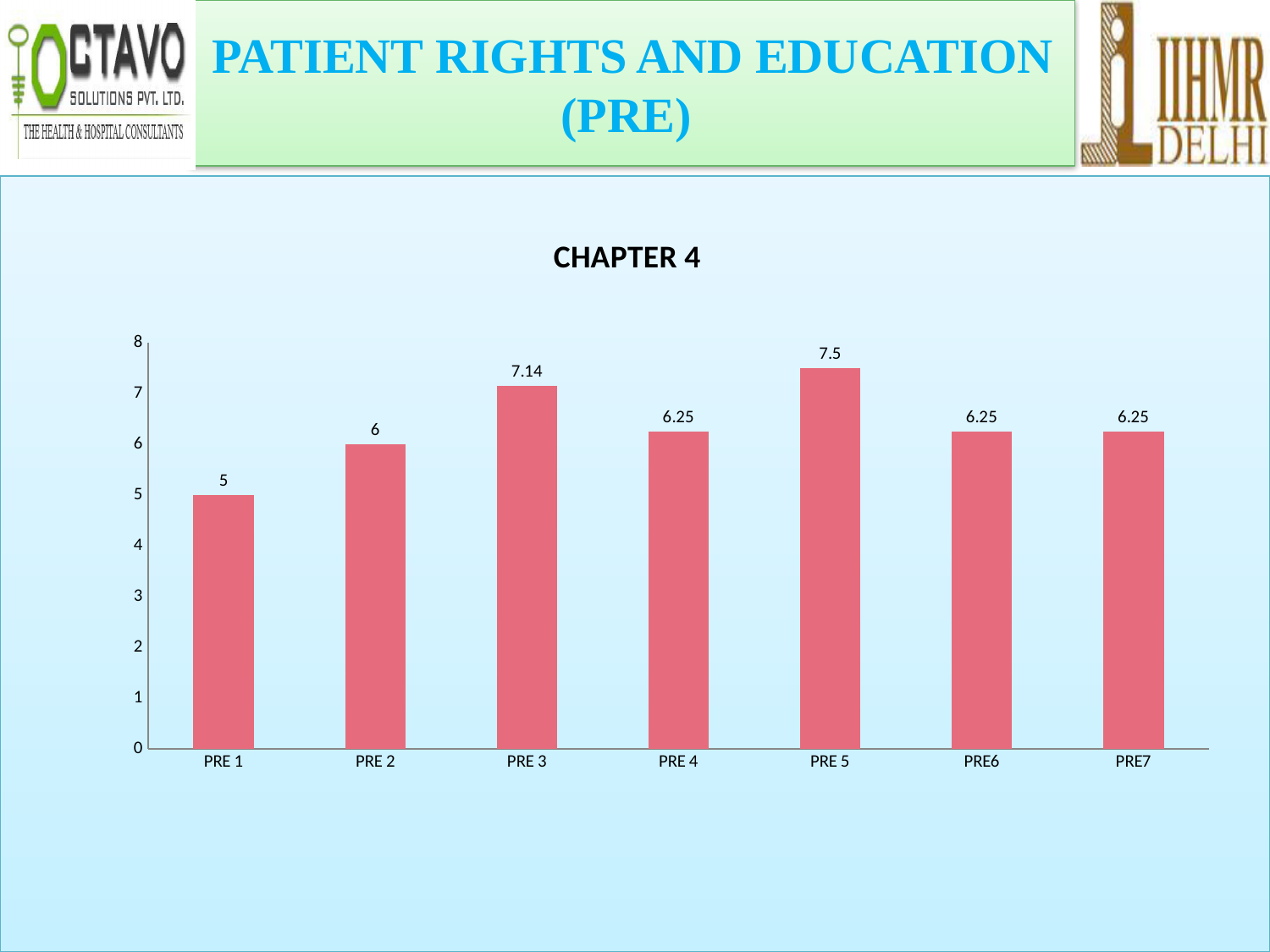
What is the difference between the values for PRE 3 and PRE 2? 1.14 Which category has the highest value? PRE 5 What is the value for PRE 1? 5 Which is larger, the value for PRE 3 or the value for PRE 4? PRE 3 Which category has the lowest value? PRE 1 What is the value for PRE6? 6.25 What is the title of the chart? CHAPTER 4 What is the difference between the values for PRE 5 and PRE 1? 2.5 How many categories are shown on the x axis? 7 What kind of chart is shown on the slide? bar chart Is the value for PRE 5 greater or less than 7? greater What is the value for PRE 3? 7.14